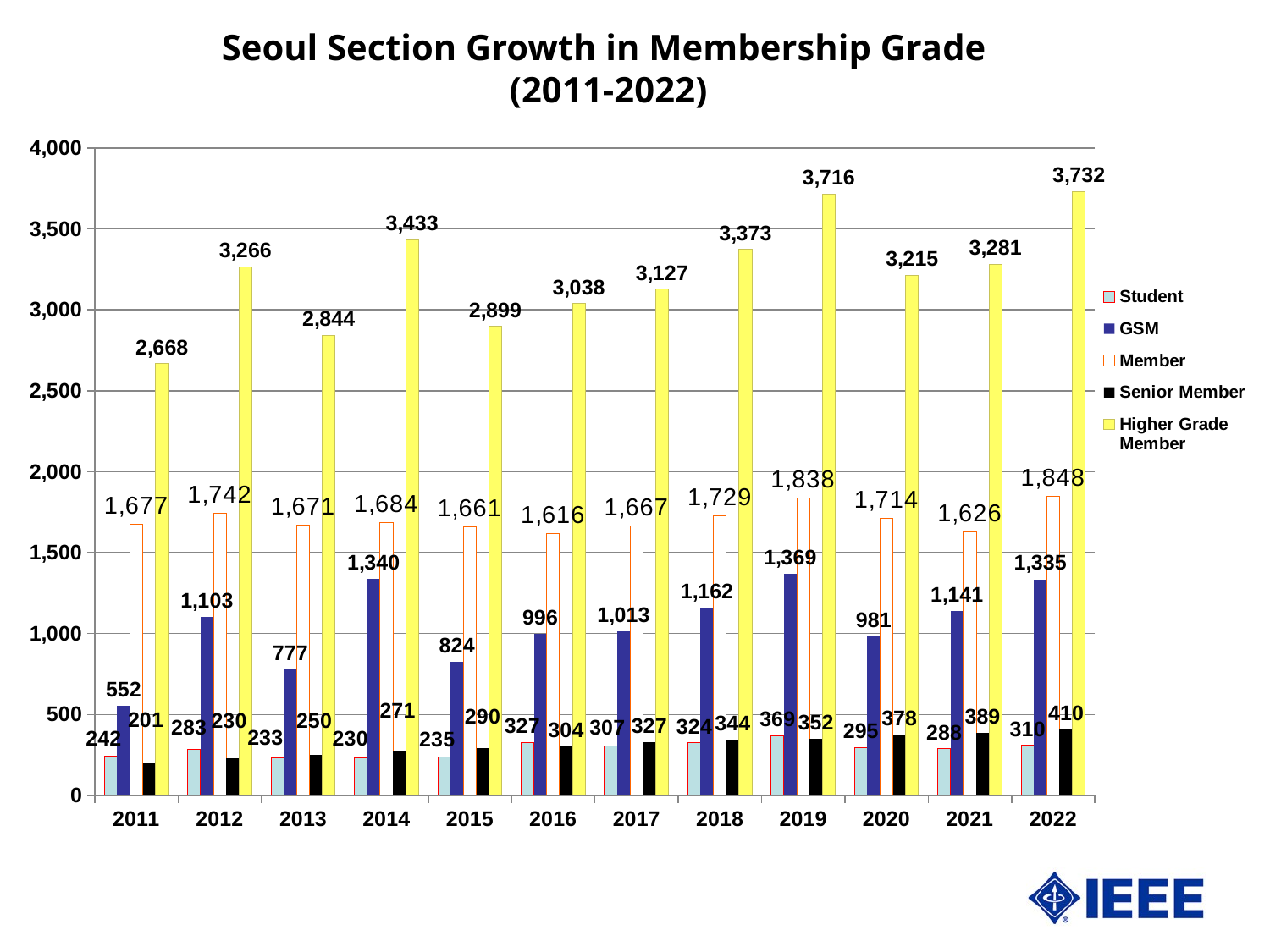
What is the value for Senior Member in 2011? 201 What is the value for GSM in 2014? 1,340 In which year is the Student value highest? 2019 What is the value for Higher Grade Member in 2022? 3,732 Which series is shown in yellow? Higher Grade Member In which year is the Higher Grade Member value lowest? 2011 What is the difference between the GSM values in 2022 and 2011? 783 How many years are shown on the x axis? 12 Which is larger, the Member value in 2012 or the Member value in 2013? 2012 What kind of chart is this? Bar chart How many series does the legend list? 5 What is the value for Member in 2019? 1,838